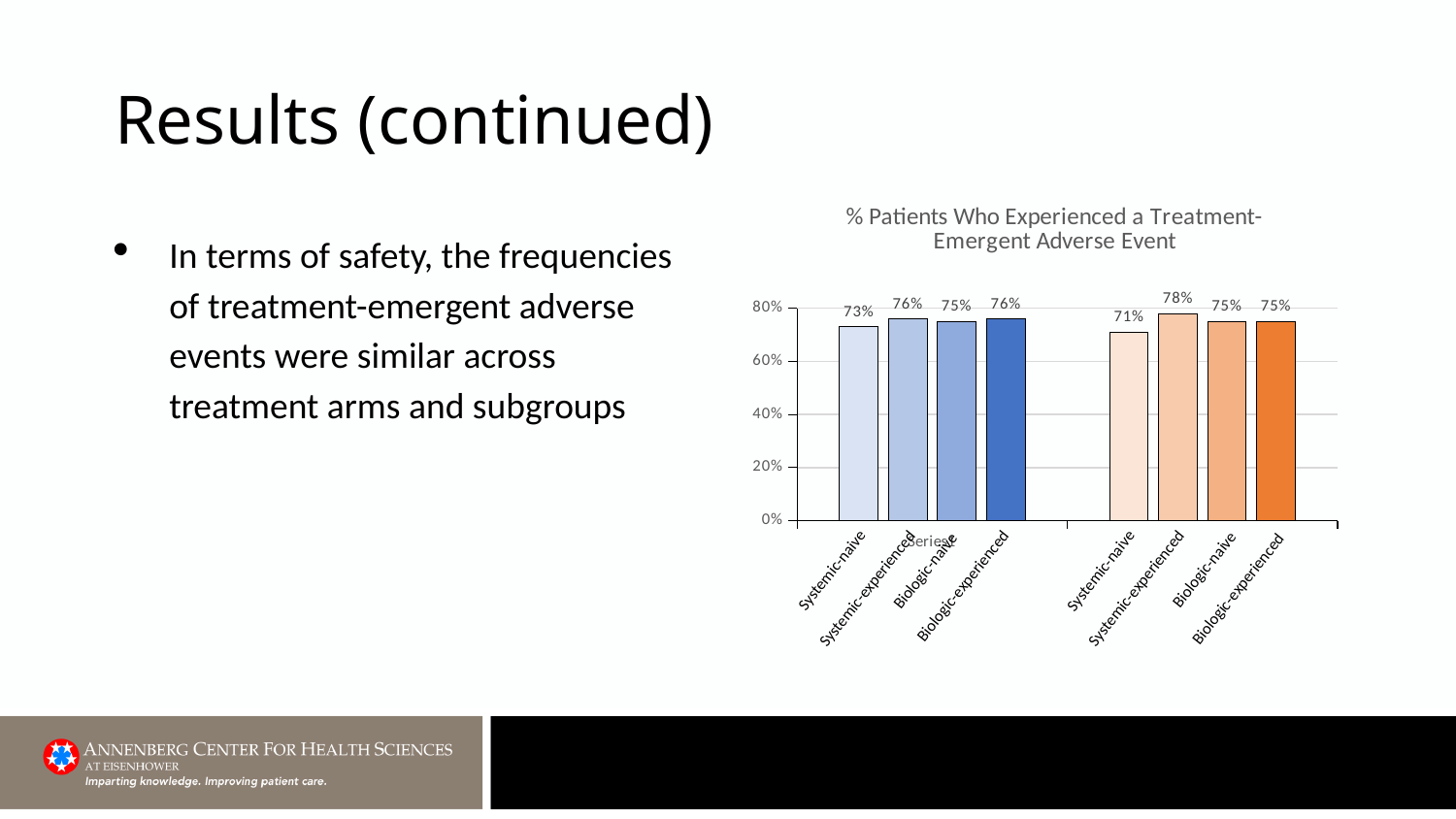
In the right (orange) group, what is the difference between the Systemic-experienced and Systemic-naive values? 7 percentage points Is the value for Biologic-naive in the left (blue) group greater or less than 80%? less In the left (blue) group, what is the difference between the Systemic-experienced and Systemic-naive values? 3 percentage points What is the title of the chart? % Patients Who Experienced a Treatment-Emergent Adverse Event Which bar has the highest value on the chart? Systemic-experienced in the right (orange) group, 78% Which is larger: the Systemic-naive value in the left (blue) group or the Systemic-naive value in the right (orange) group? The left (blue) group, 73% What is the value for Systemic-naive in the left (blue) group of bars? 73% How many bars are plotted on the chart? 8 Which bar has the lowest value on the chart? Systemic-naive in the right (orange) group, 71% What is the value for Biologic-experienced in the left (blue) group of bars? 76% What is the value for Systemic-experienced in the right (orange) group of bars? 78% What is the value for Systemic-naive in the right (orange) group of bars? 71%